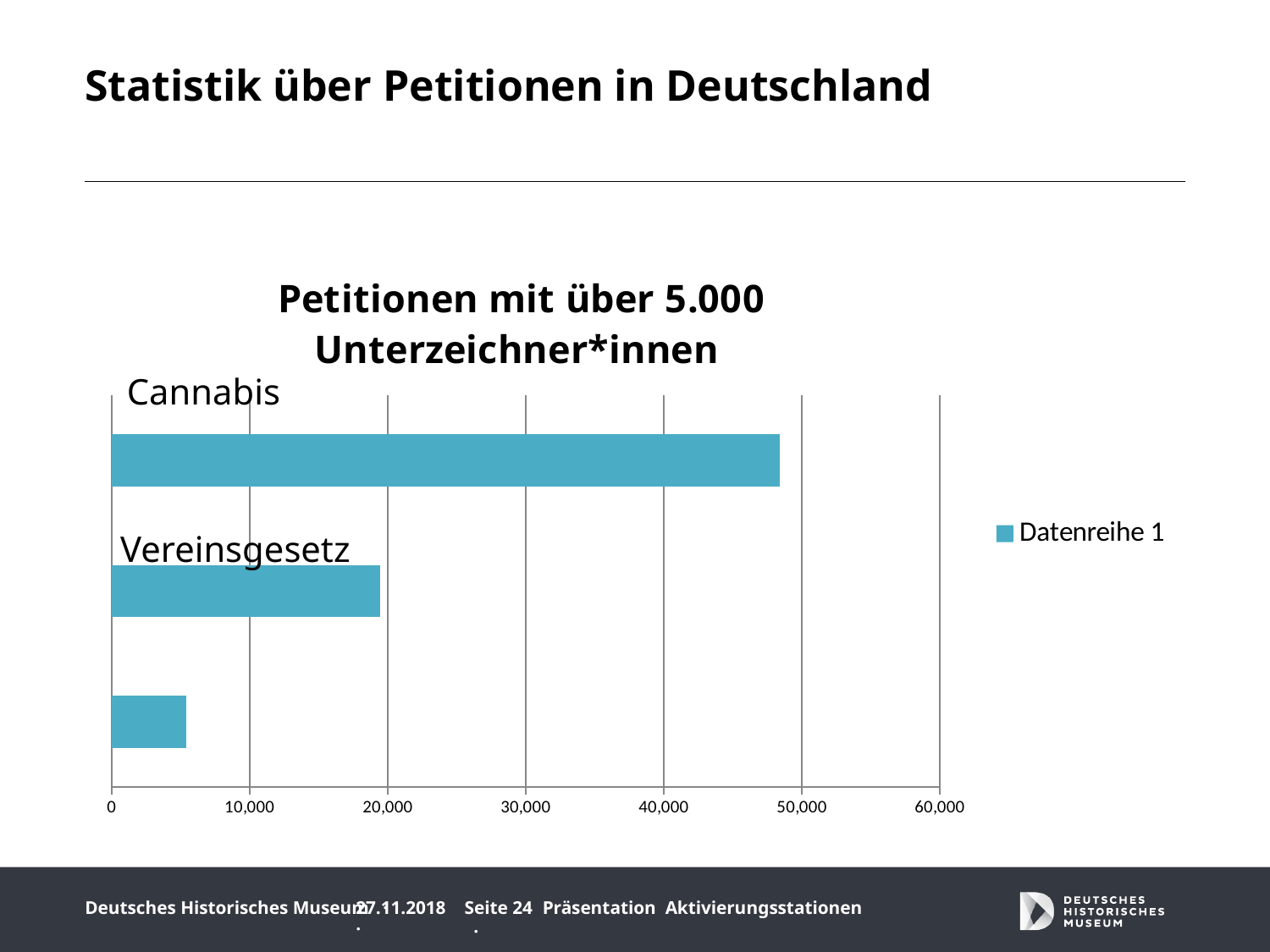
Is the value for Vereinsgesetz greater or less than 30,000? less Which is larger, the value for Cannabis or the value for Vereinsgesetz? Cannabis What kind of chart is shown on the slide? bar chart How many series does the legend list? 1 What is the highest value shown on the x axis? 60,000 What is the name of the series in the legend? Datenreihe 1 What is the title of the chart? Petitionen mit über 5.000 Unterzeichner*innen How many bars are plotted in the chart? 3 Which category has the highest value? Cannabis Is the value for Cannabis greater or less than 40,000? greater Is the value for Vereinsgesetz greater or less than 10,000? greater